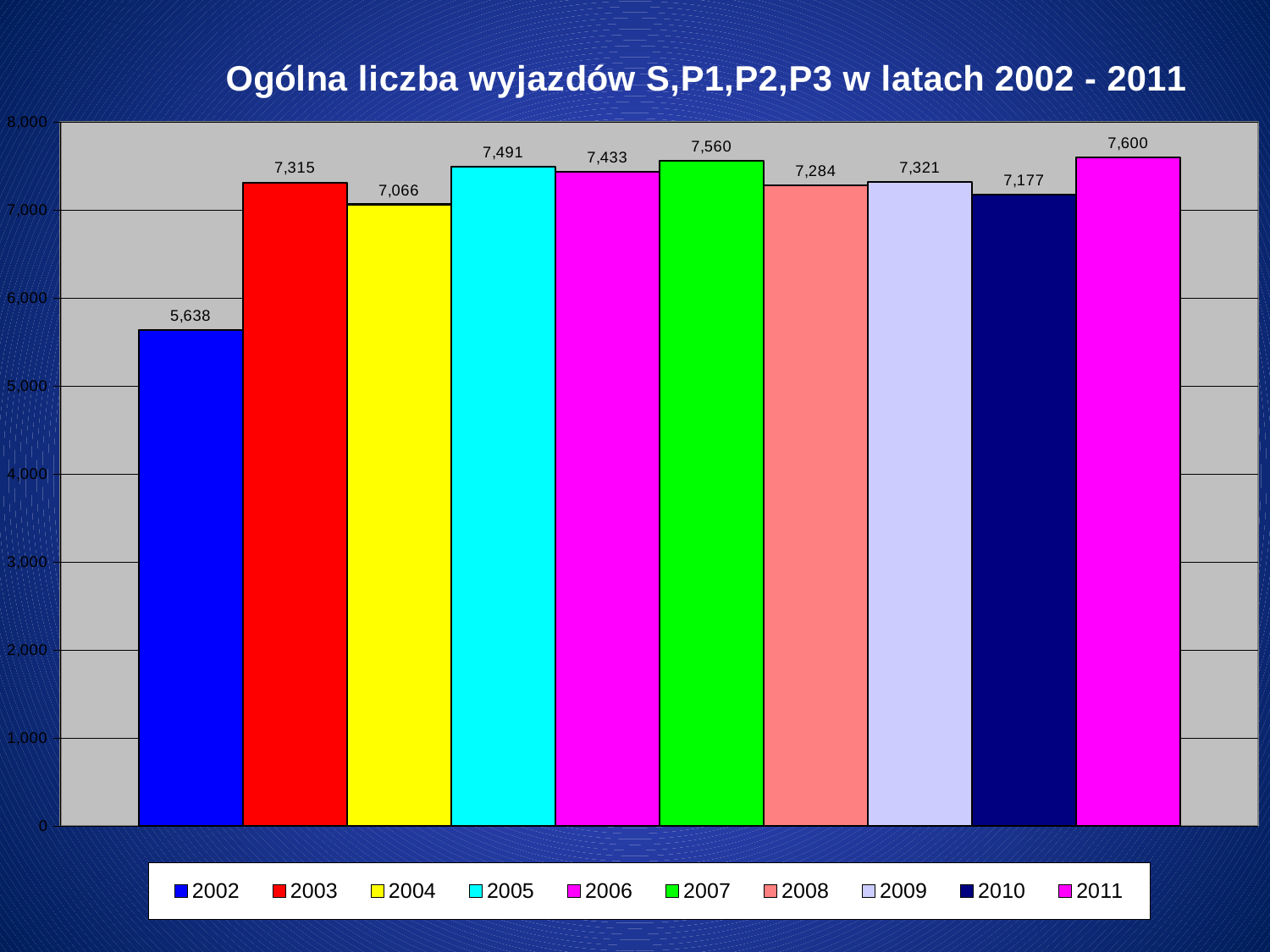
Is the value for 2002 greater or less than 6,000? less Which year has the lowest value? 2002 Which is larger, the value for 2003 or the value for 2004? 2003 What is the title of the chart? Ogólna liczba wyjazdów S,P1,P2,P3 w latach 2002 - 2011 What is the difference between the values for 2005 and 2004? 425 What kind of chart is shown on the slide? bar chart What is the value for 2007? 7,560 Which year has the highest value? 2011 What is the value for 2010? 7,177 What is the difference between the values for 2011 and 2002? 1,962 What is the value for 2002? 5,638 How many years are shown in the chart? 10